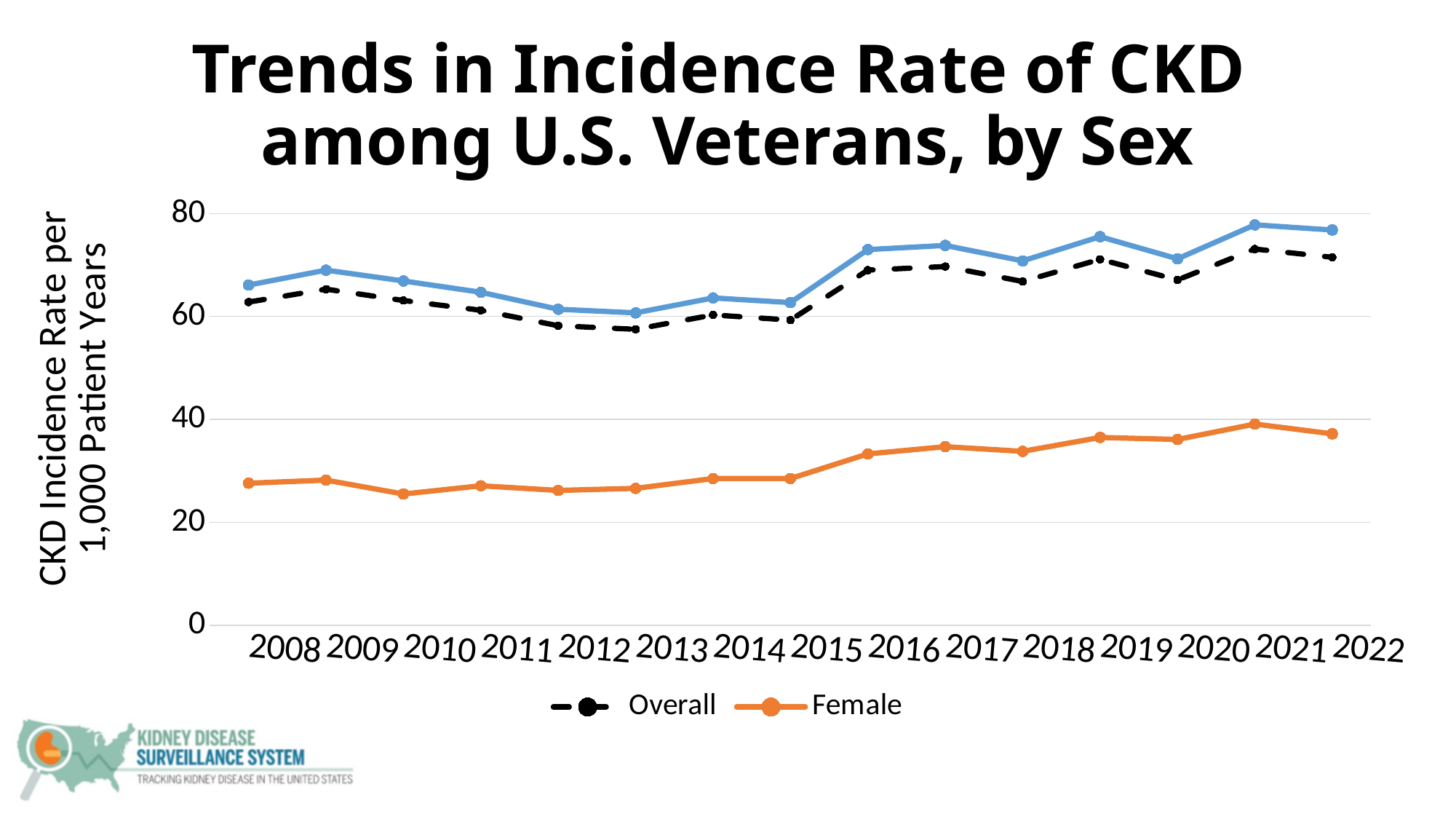
How many series does the legend list? 2 What kind of chart is shown on the slide? line chart Does the Overall line rise or fall from 2009 to 2013? fall Is the Overall value for 2008 greater or less than 60? greater How many years are shown along the x axis? 15 What is the label on the y axis? CKD Incidence Rate per 1,000 Patient Years Which year has the highest Overall value? 2021 Is the Female value for 2016 greater or less than 20? greater Which is larger in 2022, the Overall value or the Female value? Overall Does the Female line rise or fall from 2014 to 2021? rise Which year has the highest Female value? 2021 Is the Female value for 2008 greater or less than 40? less